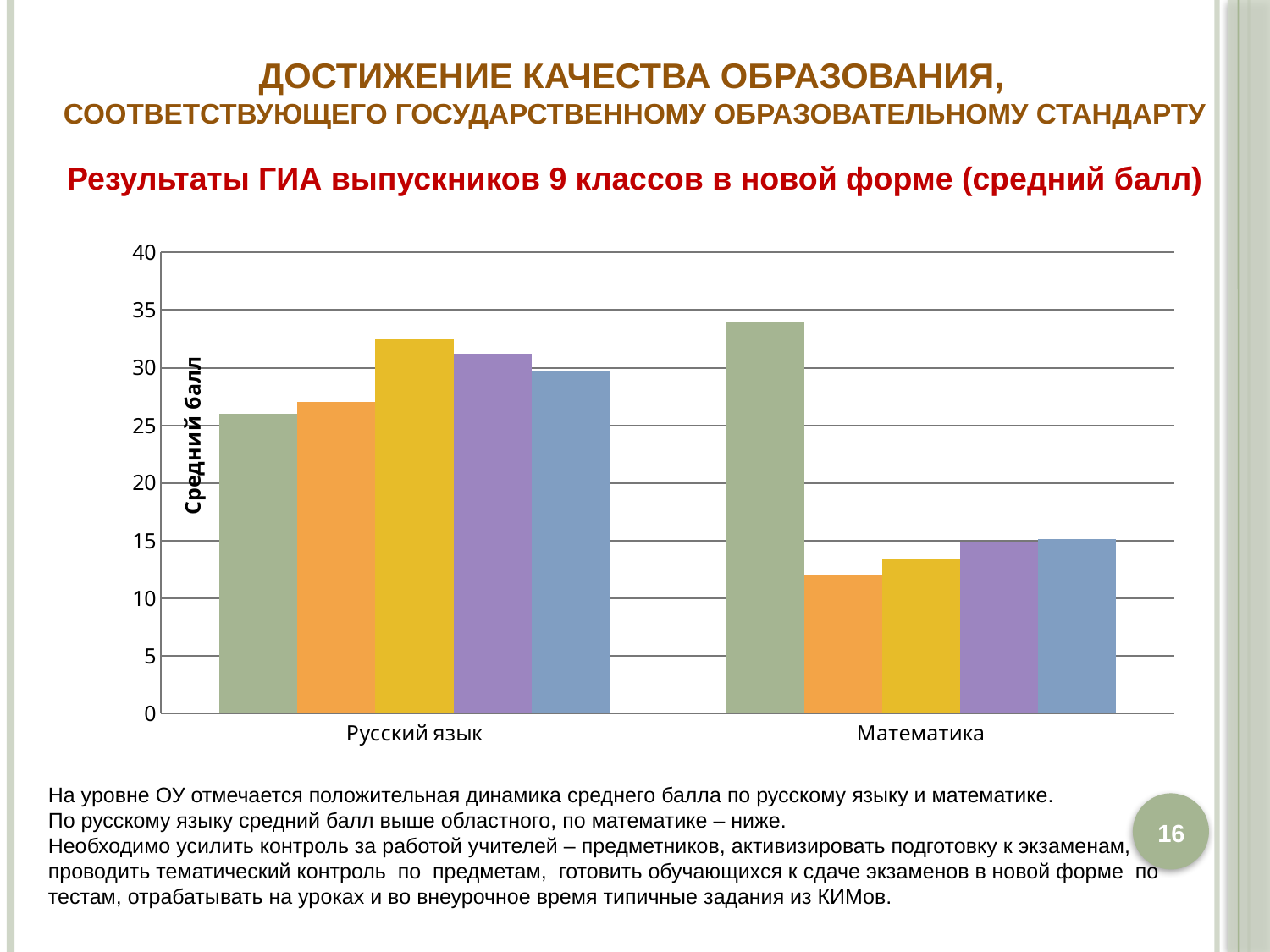
What is the label of the vertical axis of the chart? Средний балл Is the value of the second (orange) bar for Математика greater or less than 15? less Which bar is the lowest within the Математика category? the second (orange) bar Is the value of the first (green) bar for Русский язык greater or less than 25? greater What kind of chart is shown on the slide? bar chart Which bar is the highest within the Математика category? the first (green) bar Is the value of the third (yellow) bar for Русский язык greater or less than 30? greater How many categories are shown on the x axis of the chart? 2 Is the green bar larger for Русский язык or for Математика? Математика What are the two categories on the x axis of the chart? Русский язык, Математика Which bar is the highest within the Русский язык category? the third (yellow) bar